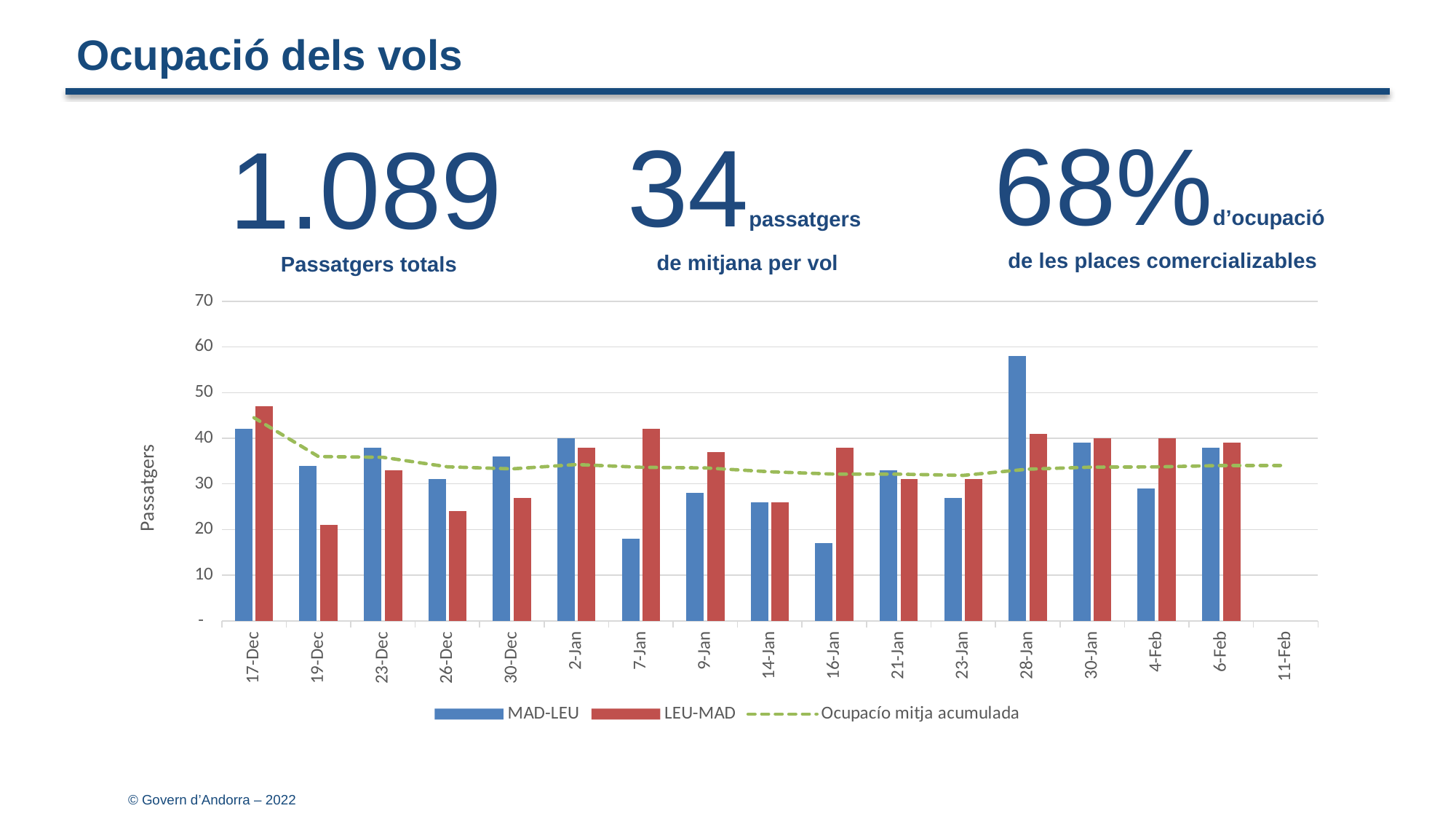
Is the LEU-MAD value for 19-Dec greater or less than 30? less What kind of chart is shown on the slide? Bar chart with a line Which date has the lowest LEU-MAD value? 19-Dec On 7-Jan, which series has the larger value, MAD-LEU or LEU-MAD? LEU-MAD Which date has the highest LEU-MAD value? 17-Dec Is the MAD-LEU value for 28-Jan greater or less than 50? greater Is the MAD-LEU value for 7-Jan greater or less than 20? less On 19-Dec, which series has the larger value, MAD-LEU or LEU-MAD? MAD-LEU What is the label of the vertical axis? Passatgers How many dates are shown on the x axis? 17 Which date has the highest MAD-LEU value? 28-Jan How many series does the legend list? 3